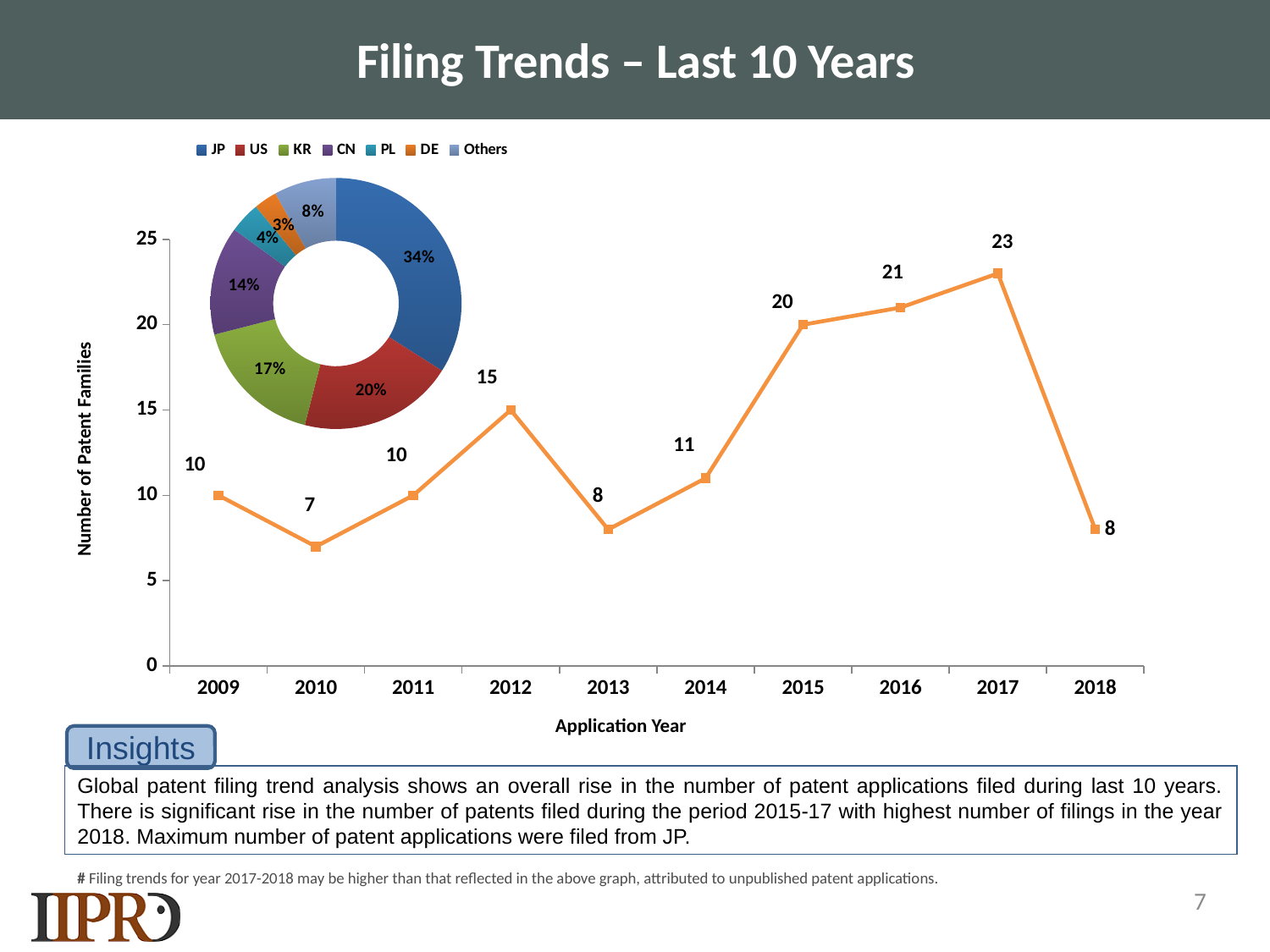
In the line chart, which application year has the lowest number of patent families? 2010 In the donut chart, which country has the smallest share? DE In the line chart, what is the number of patent families for application year 2012? 15 In the line chart, how many patent families were filed in 2017? 23 In the line chart, how many application years are plotted on the x axis? 10 How many entries does the legend of the donut chart list? 7 In the line chart, which year has more patent families, 2015 or 2014? 2015 What is the title of the slide containing the charts? Filing Trends – Last 10 Years In the donut chart, what share does JP hold? 34% In the line chart, what is the difference between the number of patent families in 2017 and in 2018? 15 In the line chart, does the number of patent families rise or fall from 2013 to 2017? rise In the line chart, which application year has the highest number of patent families? 2017